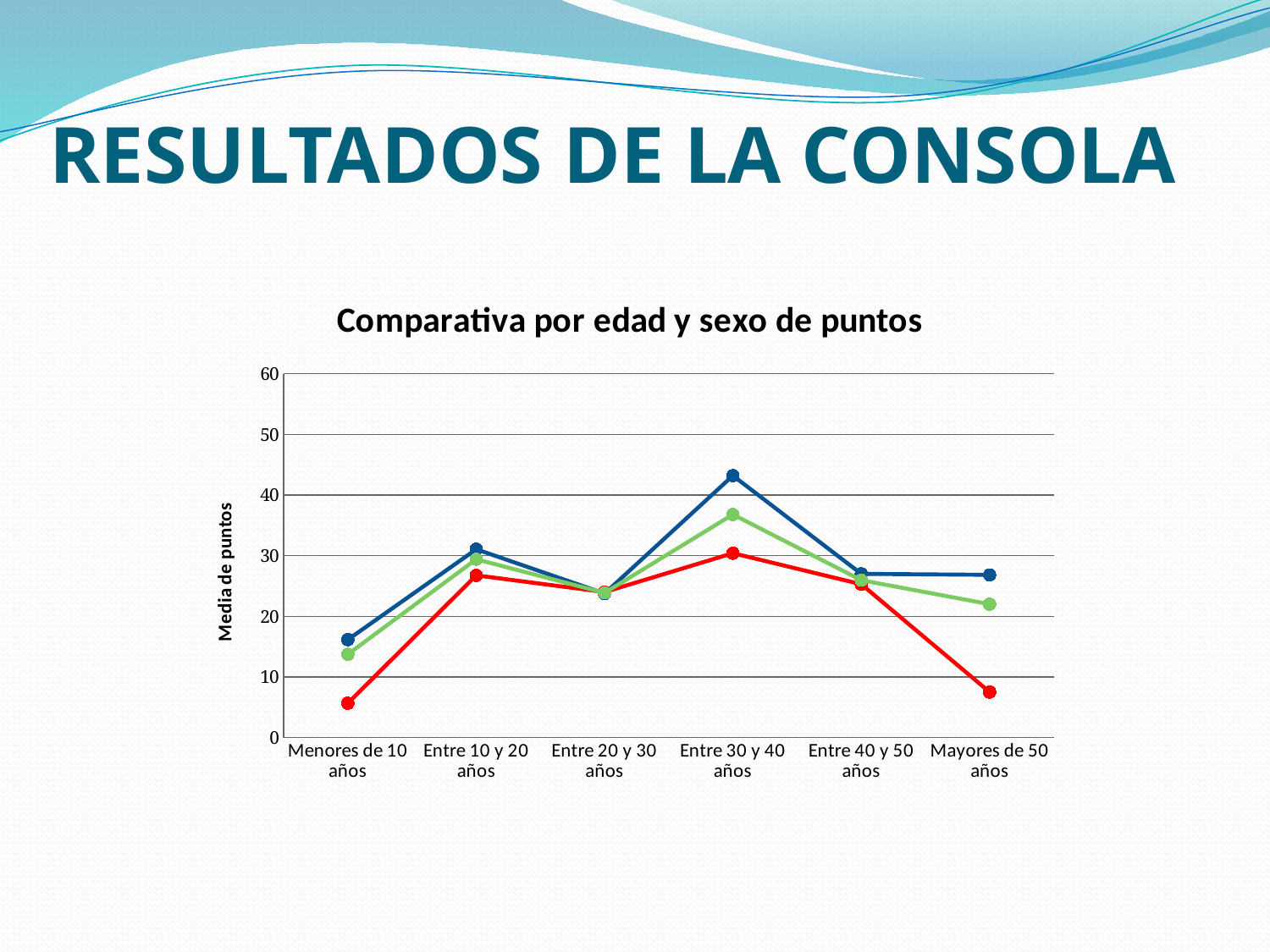
How many lines are plotted on the chart? 3 How many age groups are shown on the x axis? 6 For the blue line, which age group has the highest value? Entre 30 y 40 años Is the value of the blue line for Entre 30 y 40 años greater or less than 40? greater What is the label of the vertical axis? Media de puntos What is the title of the chart? Comparativa por edad y sexo de puntos Which age group has the highest value of any line on the chart? Entre 30 y 40 años Is the value of the green line for Entre 30 y 40 años greater or less than 40? less For Mayores de 50 años, which line has the larger value, the blue line or the red line? Blue line Do the lines rise or fall from Entre 30 y 40 años to Entre 40 y 50 años? Fall Is the value of the red line for Menores de 10 años greater or less than 10? less What type of chart is shown on the slide? Line chart